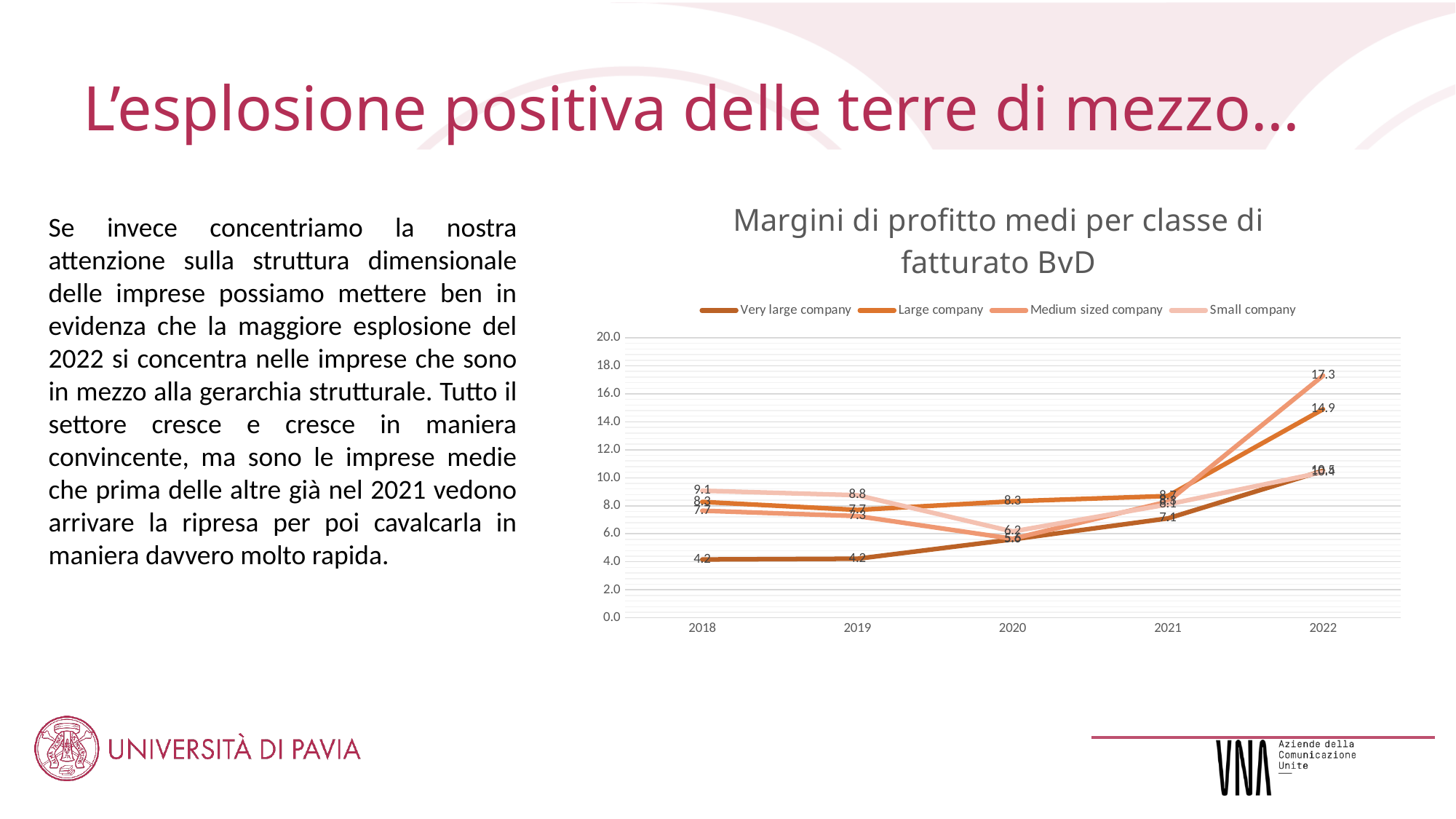
What is the value for Large company in 2022? 14.9 What is the value for Very large company in 2018? 4.2 What is the value for Very large company in 2021? 7.1 How many series does the legend of the chart list? 4 Which series has the highest value in 2022? Medium sized company What is the value for Medium sized company in 2022? 17.3 What is the difference between the Medium sized company and Large company values in 2022? 2.4 Which series has the lowest value in 2018? Very large company How many years are shown on the x axis of the chart? 5 Is the value for Very large company in 2022 greater or less than 10.0? greater What is the value for Small company in 2018? 9.1 What type of chart is shown on the slide? Line chart